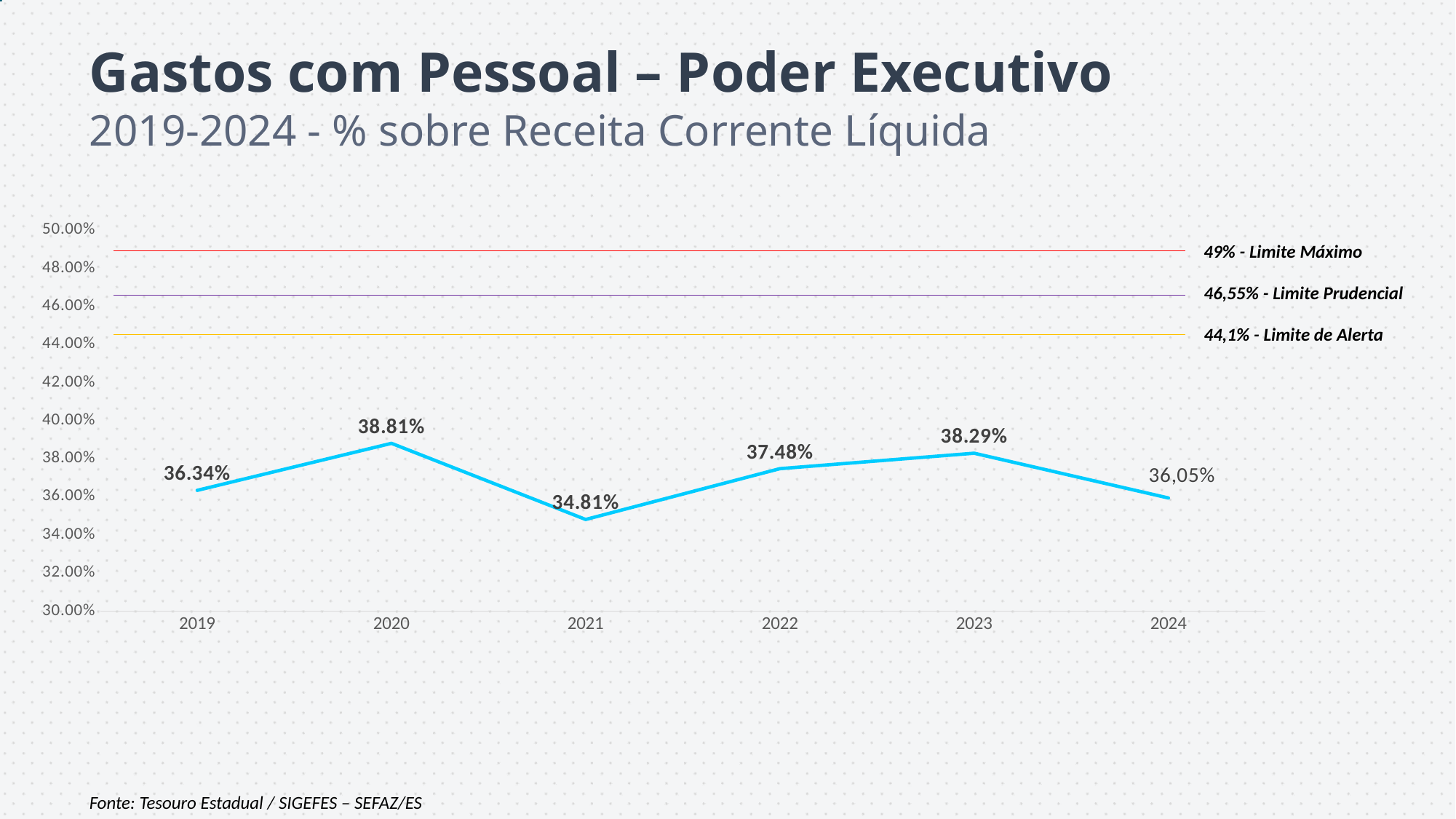
What is the value for 2024? 36,05% What is the difference between the values for 2020 and 2021? 4.00% How many years are plotted on the chart? 6 What percentage is labelled as the 'Limite Máximo' reference line? 49% Which year has the highest value? 2020 Which year has the lowest value? 2021 Is the value for 2021 greater or less than 36.00%? less What is the difference between the values for 2020 and 2019? 2.47% Which is larger, the value for 2022 or the value for 2023? 2023 What is the value for 2020? 38.81% What is the value for 2021? 34.81% What type of chart is shown on the slide? line chart